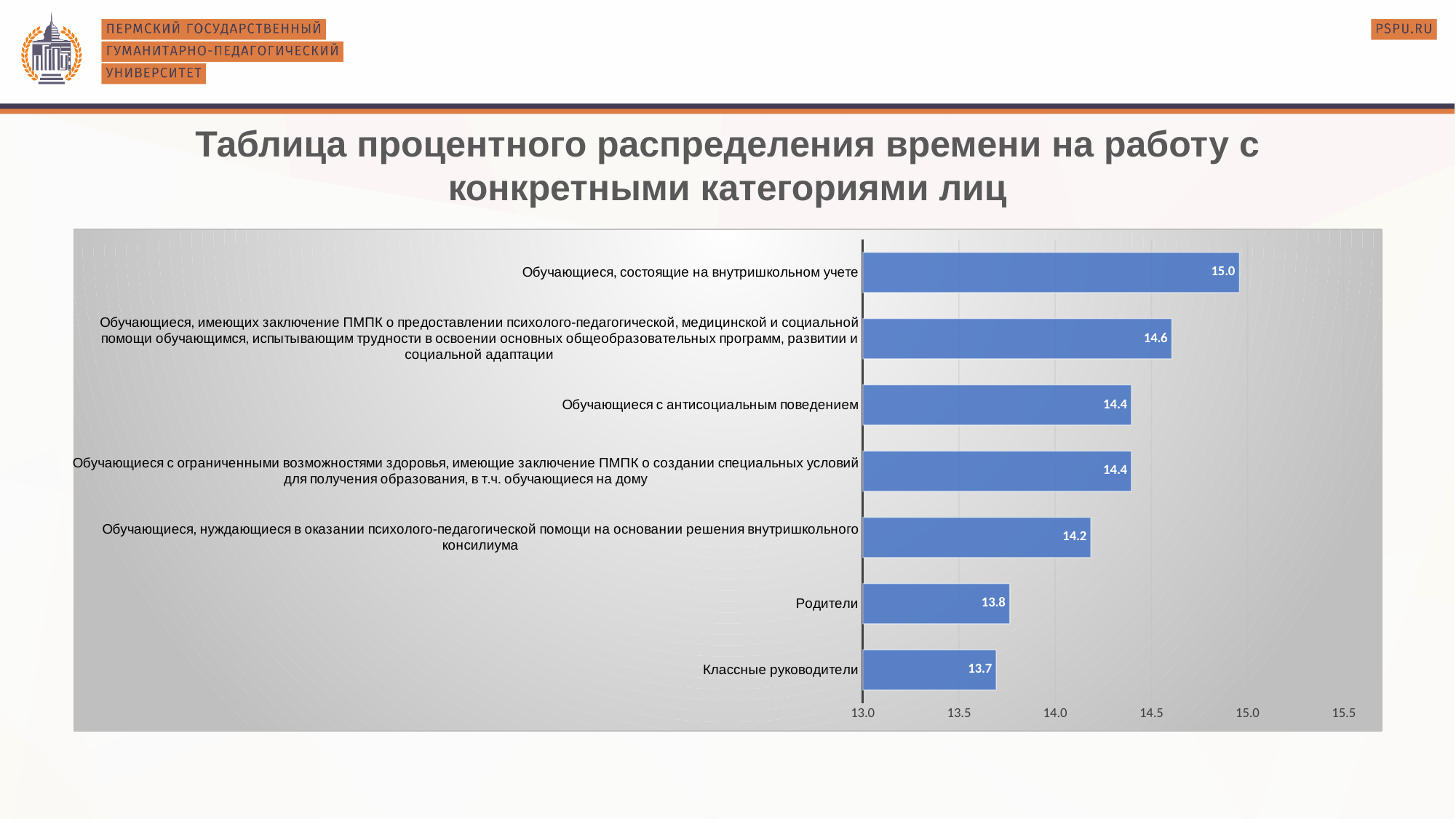
What is the value for Обучающиеся, состоящие на внутришкольном учете? 15.0 How many categories are shown in the chart? 7 Which is larger: the value for Родители or the value for Обучающиеся с антисоциальным поведением? Обучающиеся с антисоциальным поведением What is the difference between the value for Обучающиеся, состоящие на внутришкольном учете and the value for Классные руководители? 1.3 Is the value for Родители greater or less than 14.0? less What is the value for Классные руководители? 13.7 What is the title of the slide? Таблица процентного распределения времени на работу с конкретными категориями лиц What kind of chart is shown on the slide? bar chart Which category has the highest value? Обучающиеся, состоящие на внутришкольном учете Which category has the lowest value? Классные руководители What is the value for Обучающиеся с антисоциальным поведением? 14.4 What is the value for Родители? 13.8